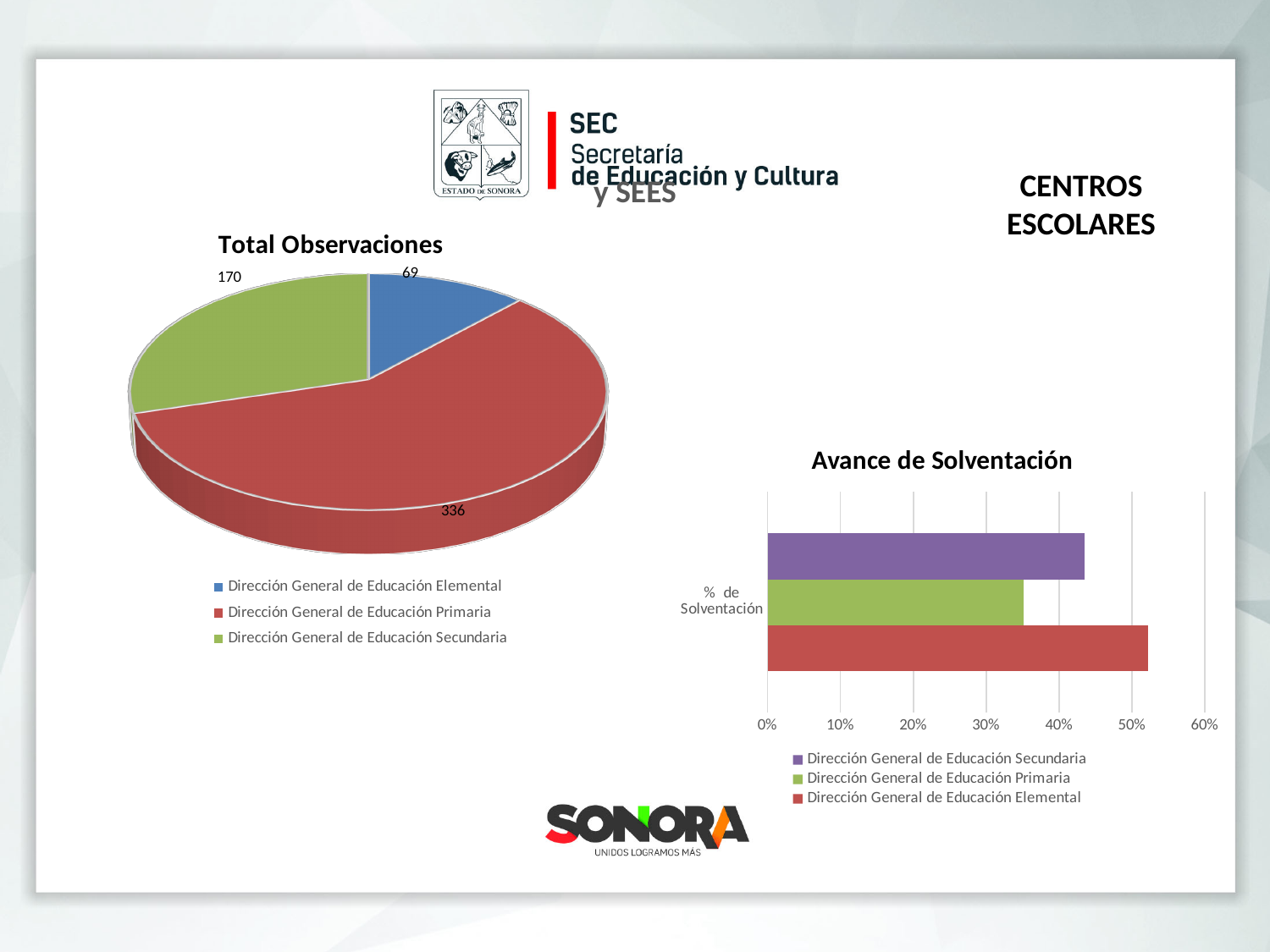
How many series does the legend of the Avance de Solventación chart list? 3 In the Total Observaciones pie chart, which category has the largest slice? Dirección General de Educación Primaria In the Total Observaciones pie chart, what is the value for Dirección General de Educación Secundaria? 170 In the Avance de Solventación chart, which series has the longest bar? Dirección General de Educación Elemental In the Total Observaciones pie chart, what is the difference between the values for Primaria and Secundaria? 166 What kind of chart is Avance de Solventación? Bar chart In the Total Observaciones pie chart, what is the total of all three slices? 575 In the Total Observaciones pie chart, what is the value for Dirección General de Educación Primaria? 336 In the Avance de Solventación chart, is the value for Dirección General de Educación Primaria greater or less than 40%? less In the Total Observaciones pie chart, what is the value for Dirección General de Educación Elemental? 69 How many slices does the Total Observaciones pie chart have? 3 In the Total Observaciones pie chart, which category has the smallest slice? Dirección General de Educación Elemental